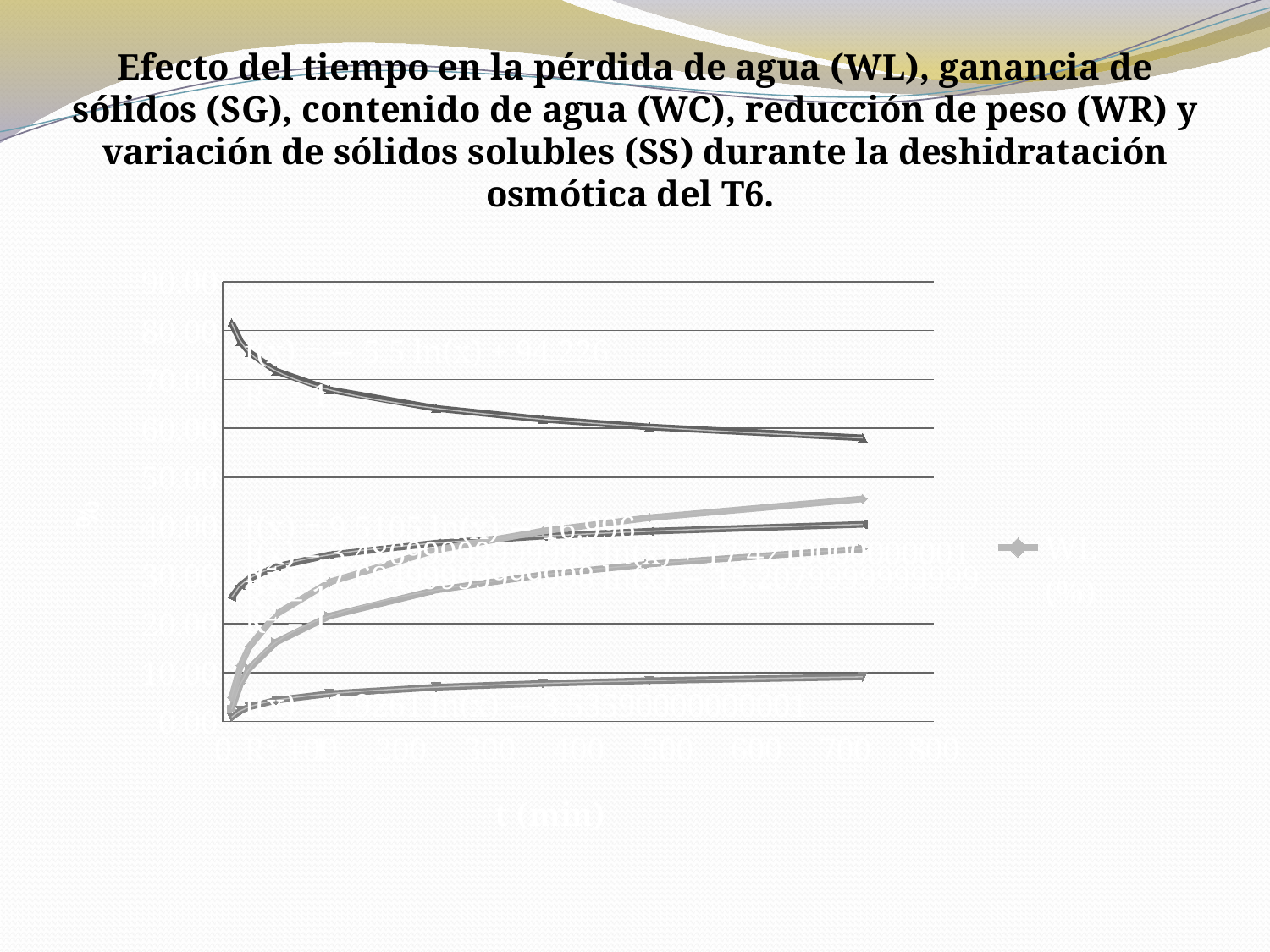
What is the highest tick value shown on the y axis of the chart? 90.00 How many lines are plotted in the chart? 5 Does the lowest line in the chart rise or fall as t increases? rise What is the label of the x axis of the chart? t (min) What kind of chart is shown on the slide? line chart Does the topmost line in the chart rise or fall as t increases? fall Is the value of the topmost line at t = 0 greater or less than 70? greater